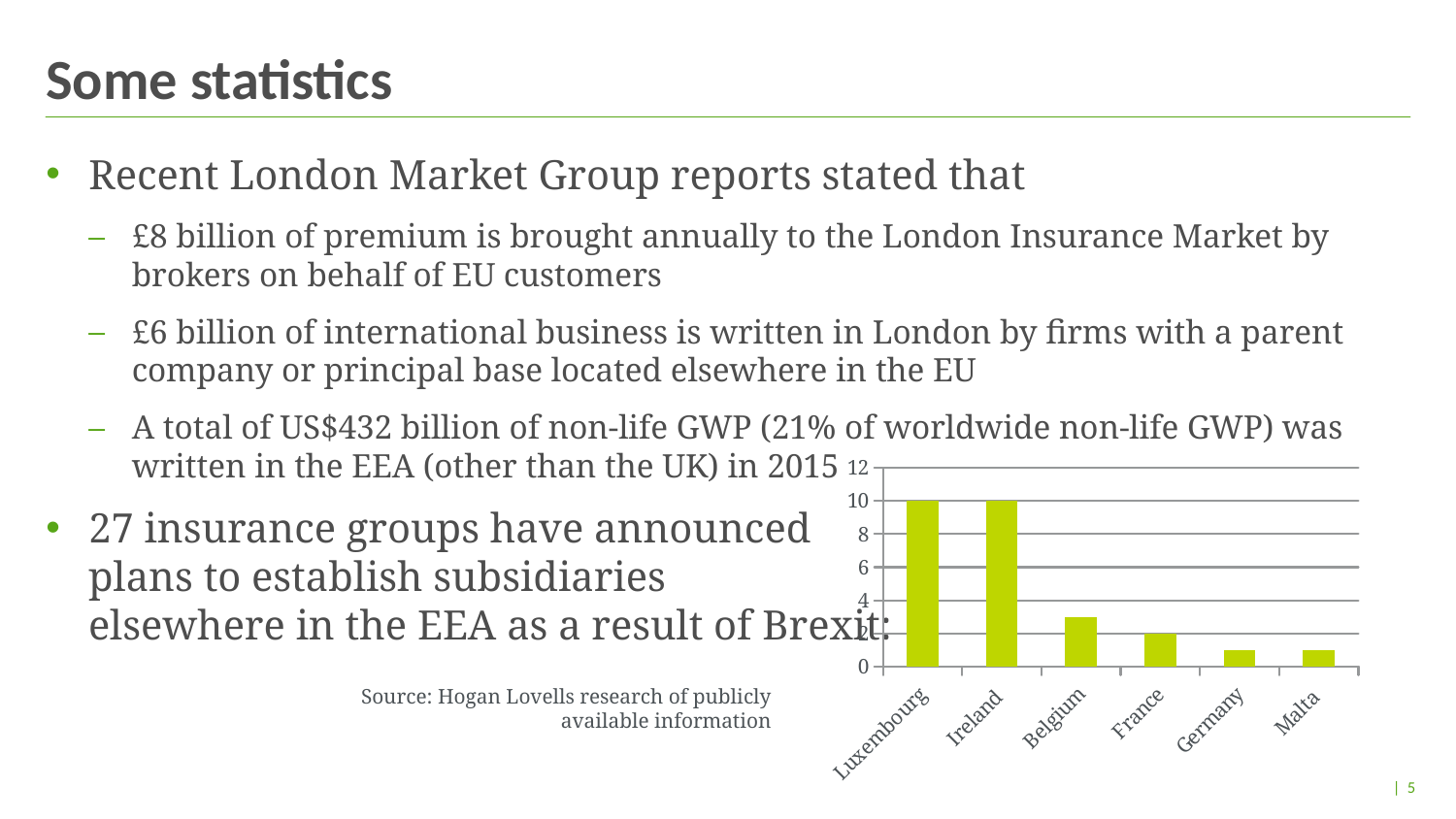
How many countries are shown on the x axis of the chart? 6 Is the value for Malta greater or less than 2? less What kind of chart is shown on the slide? bar chart What is the value for France in the chart? 2 Which has the larger value, Ireland or Belgium? Ireland Is the value for Belgium greater or less than 2? greater Do the bar values generally rise or fall from left to right along the x axis? fall Which has the larger value, Belgium or France? Belgium What is the value for Ireland in the chart? 10 Is the value for Germany greater or less than 2? less What is the value for Luxembourg in the chart? 10